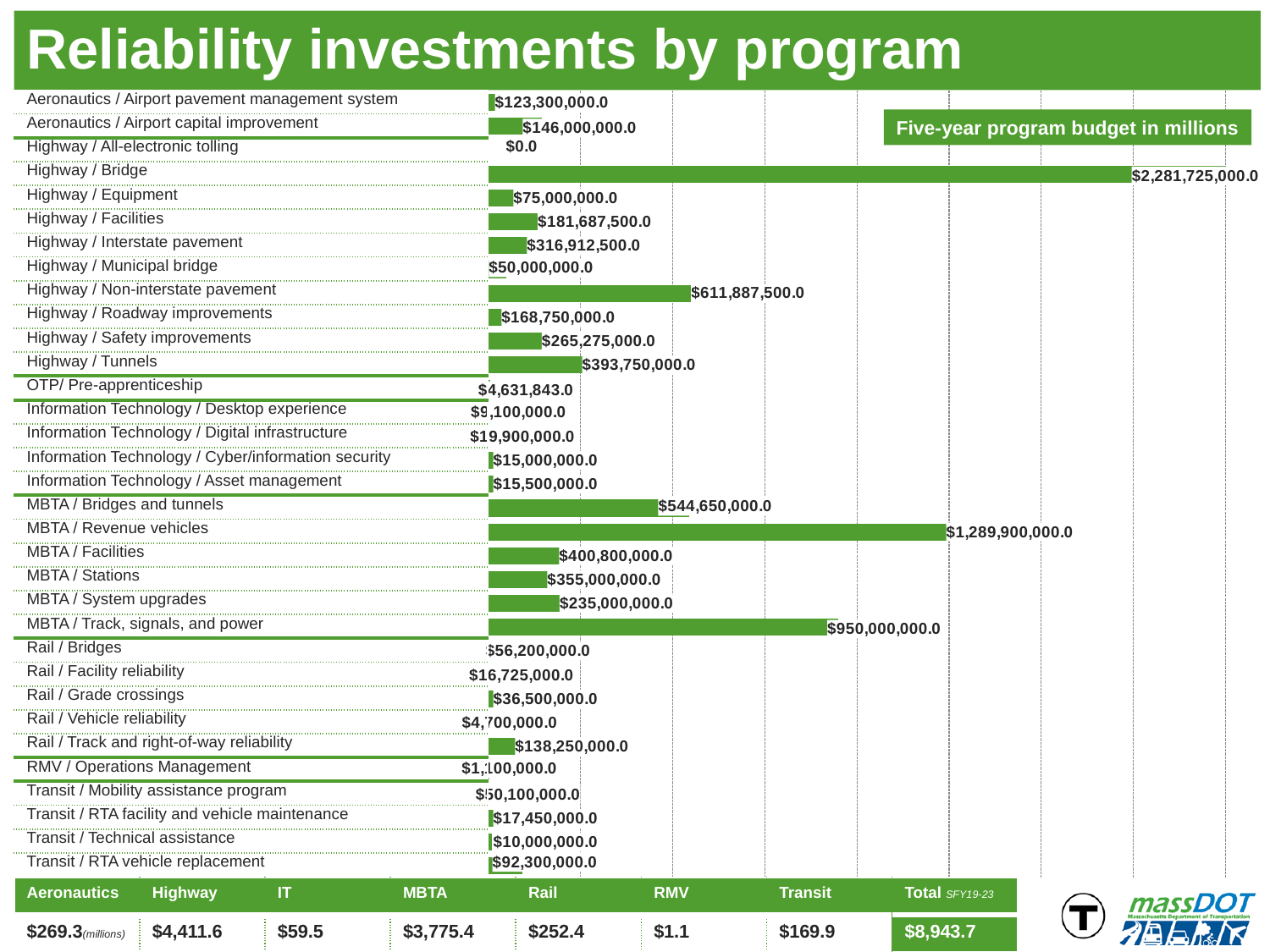
Which program has the highest value? Highway / Bridge What is the difference between Highway / Bridge and MBTA / Revenue vehicles? $991,825,000.0 What is the value for Highway / Bridge? $2,281,725,000.0 How many programs are plotted in the chart? 33 Which program has the lowest value? Highway / All-electronic tolling Which is larger, Highway / Interstate pavement or MBTA / Stations? MBTA / Stations What kind of chart is shown on the slide? Bar chart Which is larger, MBTA / Bridges and tunnels or Highway / Tunnels? MBTA / Bridges and tunnels What is the value for Rail / Track and right-of-way reliability? $138,250,000.0 What is the value for Highway / Non-interstate pavement? $611,887,500.0 What is the value for MBTA / Revenue vehicles? $1,289,900,000.0 What is the difference between MBTA / Track, signals, and power and Highway / Non-interstate pavement? $338,112,500.0